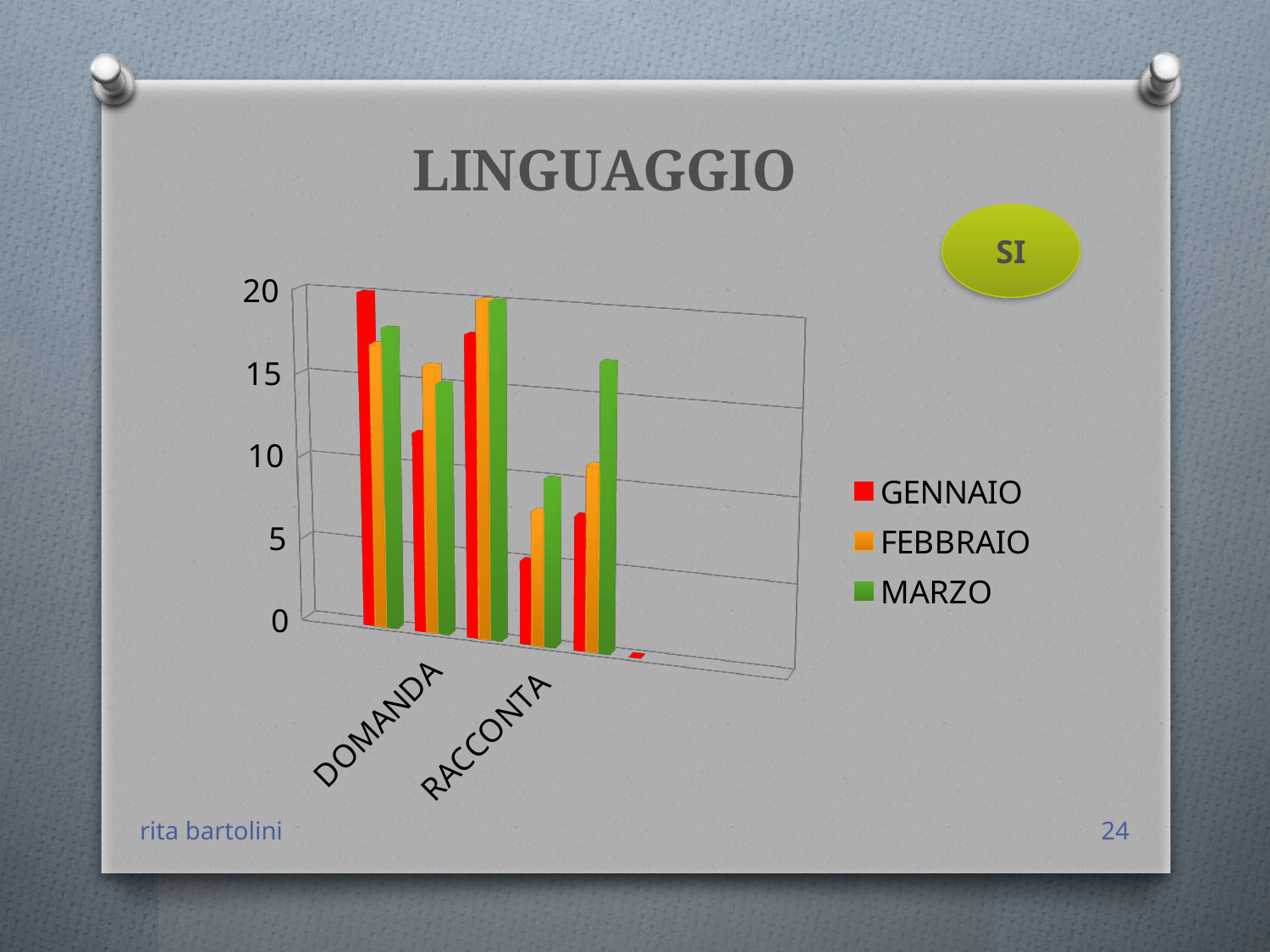
Which series is shown in green in the legend? MARZO What kind of chart is shown on the slide? bar chart What is the title of the chart? LINGUAGGIO What is the highest value shown on the vertical axis? 20 How many series does the legend list? 3